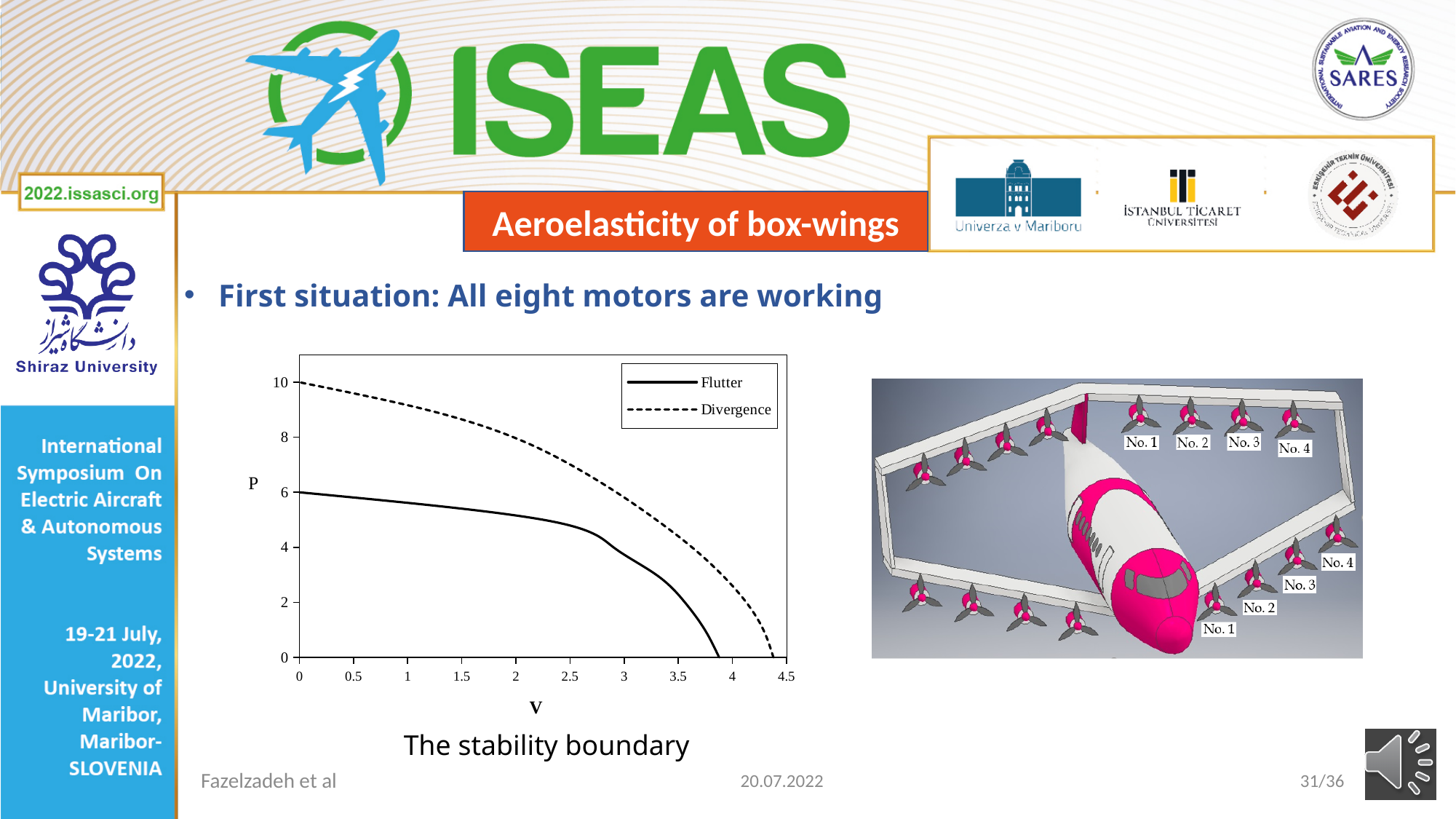
What kind of chart is shown on the slide? line chart Does the Divergence curve rise or fall as v increases? fall What labels are used for the x axis and the y axis of the chart? v (x axis) and P (y axis) Is the value of P for the Flutter curve at v = 3.5 greater or less than 4? less What is the difference between the Divergence and Flutter values of P at v = 0? 4 At v = 2, which curve has the higher value of P, Flutter or Divergence? Divergence Is the value of P for the Divergence curve at v = 2 greater or less than 6? greater What is the value of P for the Divergence curve at v = 0? 10 What is the value of P for the Flutter curve at v = 0? 6 How many series does the legend of the chart list? 2 What are the two series named in the chart legend? Flutter and Divergence Does the Flutter curve rise or fall as v increases? fall